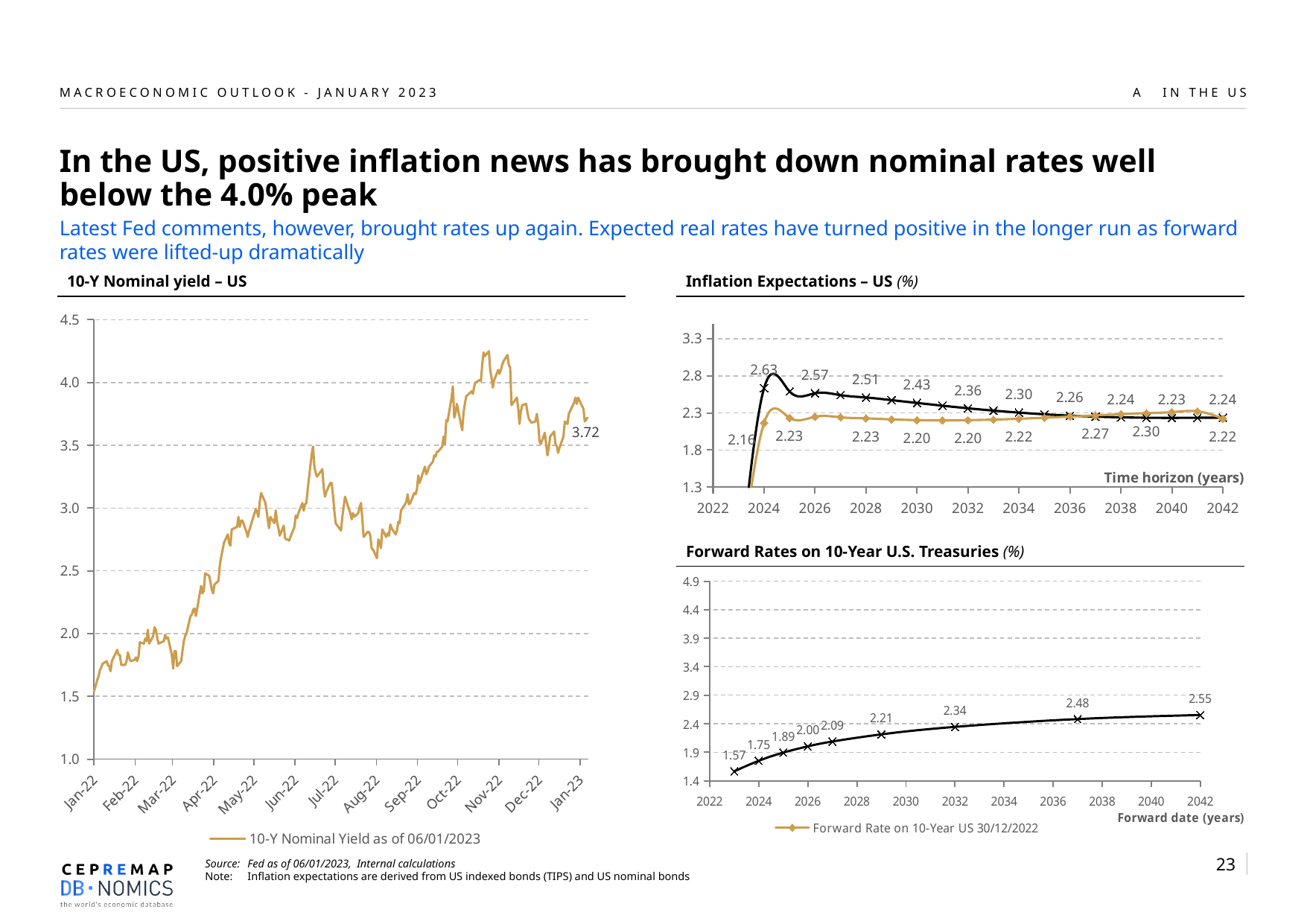
On the Forward Rates on 10-Year U.S. Treasuries chart, what is the forward rate labelled for 2042? 2.55 On the 10-Y Nominal yield – US chart, what is the value printed at the end of the line (Jan-23)? 3.72 What is the legend entry shown under the 10-Y Nominal yield – US chart? 10-Y Nominal Yield as of 06/01/2023 On the Forward Rates on 10-Year U.S. Treasuries chart, which is larger: the value labelled 2.34 (around 2032) or the value labelled 2.48 (around 2037)? 2.48 (around 2037) On the Inflation Expectations – US chart, what is the highest labelled value? 2.63 On the 10-Y Nominal yield – US chart, is the peak of the line in Nov-22 greater or less than 4.0? greater On the Forward Rates on 10-Year U.S. Treasuries chart, what is the lowest labelled value? 1.57 On the Forward Rates on 10-Year U.S. Treasuries chart, what is the difference between the 2042 value (2.55) and the first labelled value (1.57)? 0.98 On the 10-Y Nominal yield – US chart, is the yield at the start of Jan-22 greater or less than 2.0? less How many series does the legend of the Forward Rates on 10-Year U.S. Treasuries chart list? 1 What kind of chart is the 10-Y Nominal yield – US chart? line chart On the Forward Rates on 10-Year U.S. Treasuries chart, do the forward rates rise or fall as the forward date increases? rise